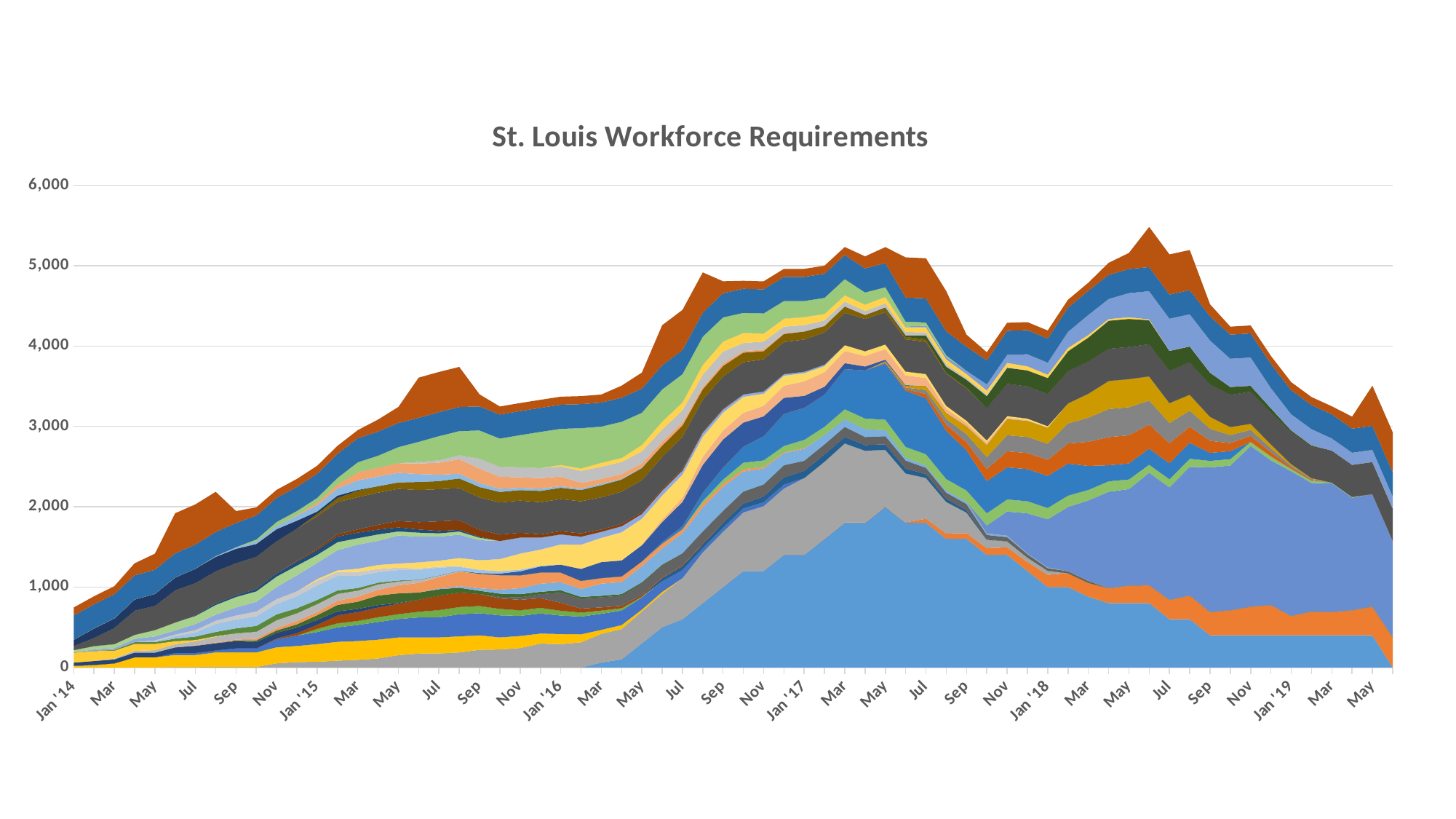
Which has the larger total stacked value, Jan '14 or Jan '15? Jan '15 Is the total stacked value at Jan '19 greater or less than 3,000? greater What kind of chart is shown on the slide? Stacked area chart Is the total stacked value at Jan '14 greater or less than 1,000? less Does the total stacked value rise or fall from Jan '14 to Jul '15? rise What is the title of the chart? St. Louis Workforce Requirements At which x-axis label is the total stacked value lowest? Jan '14 What is the highest value shown on the vertical axis? 6,000 Is the total stacked value at Jan '16 greater or less than 3,000? greater In which year does the stacked total reach its highest peak? 2018